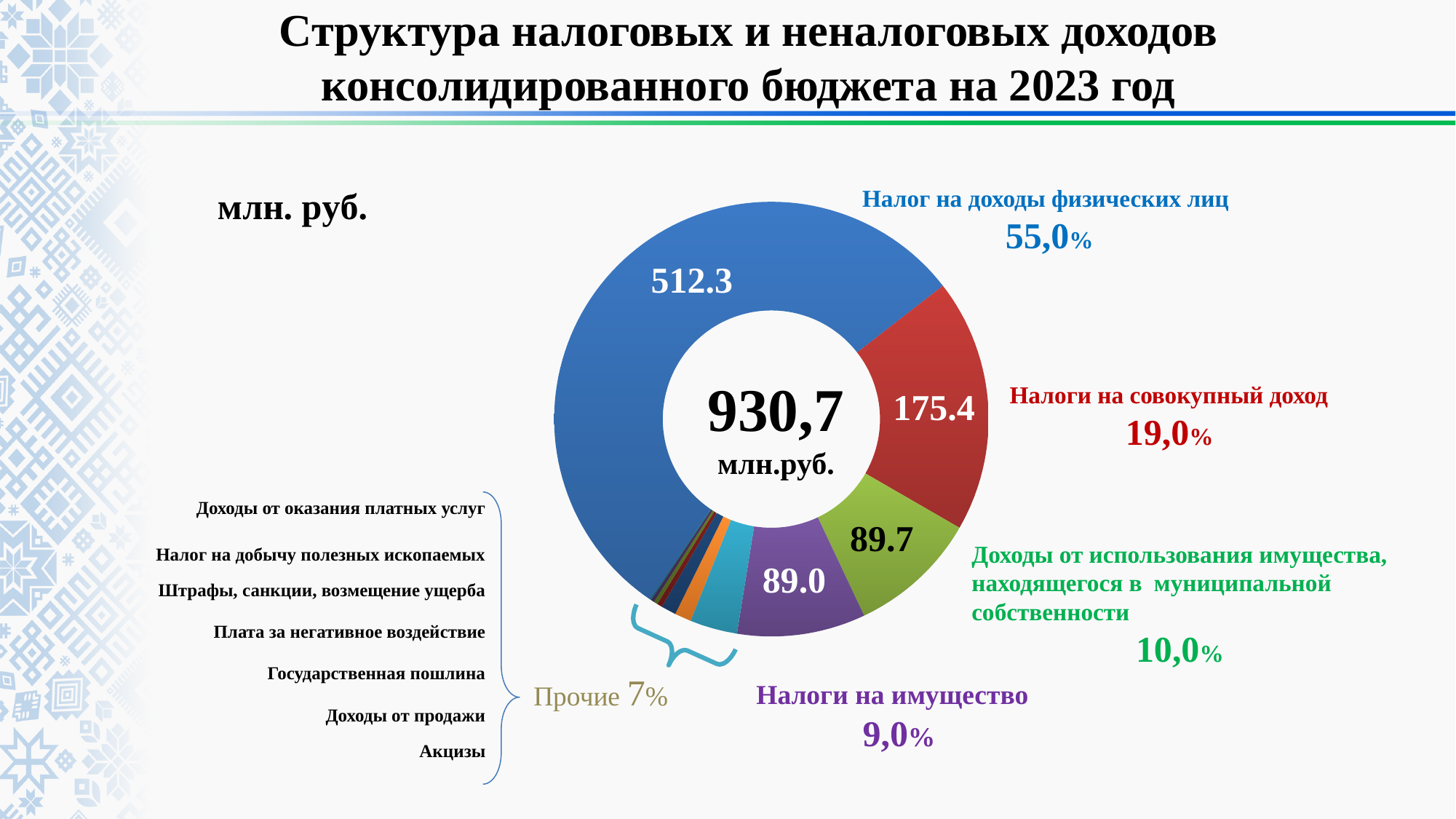
What is the difference between the values for Налог на доходы физических лиц and Налоги на совокупный доход? 336.9 Which is larger: the value for Доходы от использования имущества (89.7) or Налоги на имущество (89.0)? Доходы от использования имущества What is the value shown for Доходы от использования имущества, находящегося в муниципальной собственности? 89.7 What is the value shown for Налог на доходы физических лиц? 512.3 What share of the total do the Прочие categories account for? 7% What is the value shown for Налоги на имущество? 89.0 What share of the total does Налог на доходы физических лиц account for? 55,0% How many categories are listed under Прочие? 7 Which category has the largest slice of the chart? Налог на доходы физических лиц What is the value shown for Налоги на совокупный доход? 175.4 What kind of chart is shown on the slide? doughnut chart What total value is shown in the centre of the chart? 930,7 млн.руб.